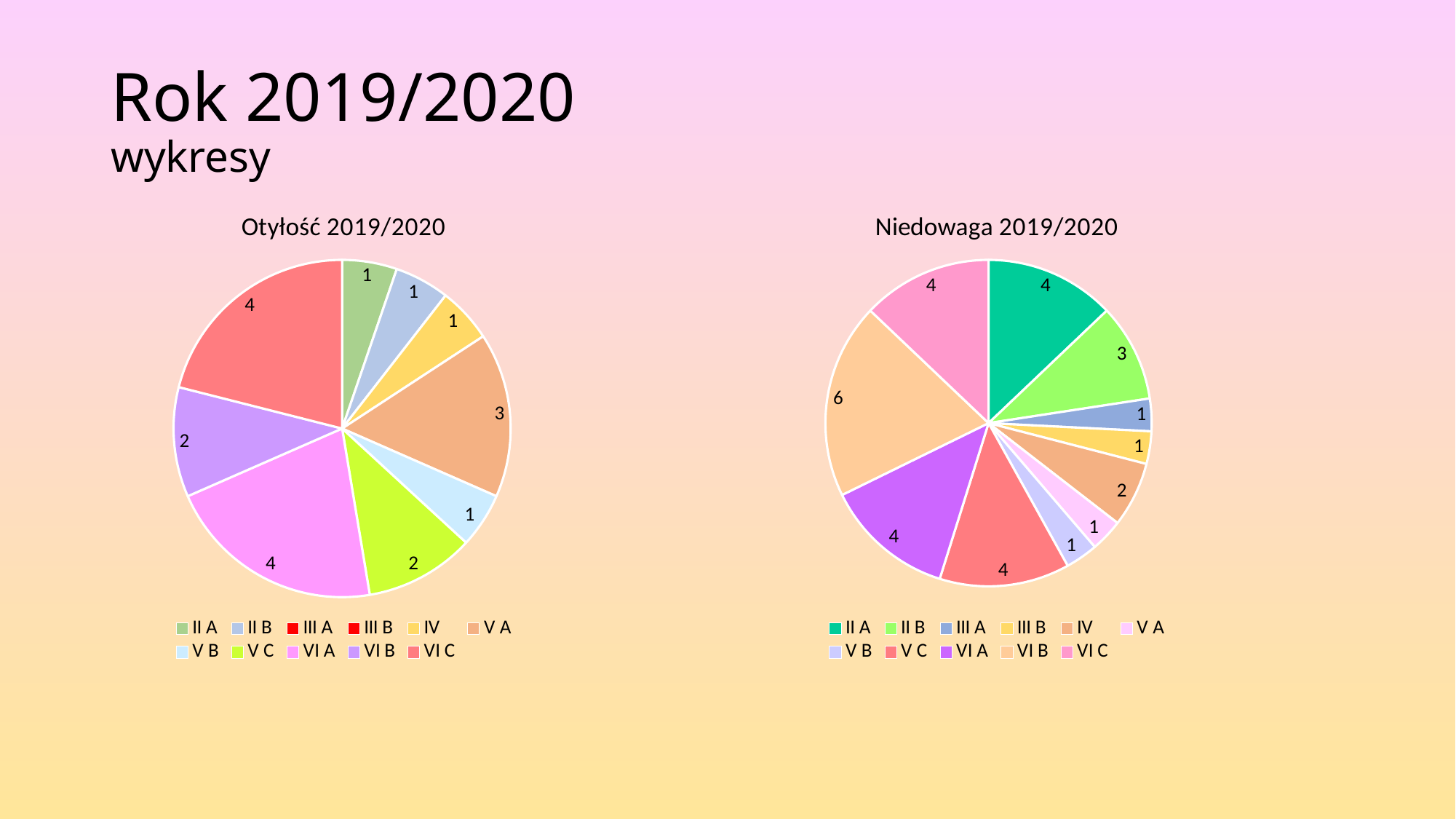
What is the title of the chart on the left side of the slide? Otyłość 2019/2020 In the Otyłość 2019/2020 chart, which is larger, the value for V A or the value for VI B? V A In the Otyłość 2019/2020 chart, what is the value for V A? 3 In the Niedowaga 2019/2020 chart, what is the difference between the values for VI B and IV? 4 In the Otyłość 2019/2020 chart, what is the difference between the values for VI A and V C? 2 In the Niedowaga 2019/2020 chart, what is the value for VI B? 6 What type of chart is the Niedowaga 2019/2020 chart? Pie chart In the Niedowaga 2019/2020 chart, which class has the largest slice? VI B In the Niedowaga 2019/2020 chart, which is larger, the value for II A or the value for II B? II A In the Otyłość 2019/2020 chart, what is the value for VI C? 4 In the Niedowaga 2019/2020 chart, what is the value for II B? 3 How many slices does the Niedowaga 2019/2020 pie chart have? 11